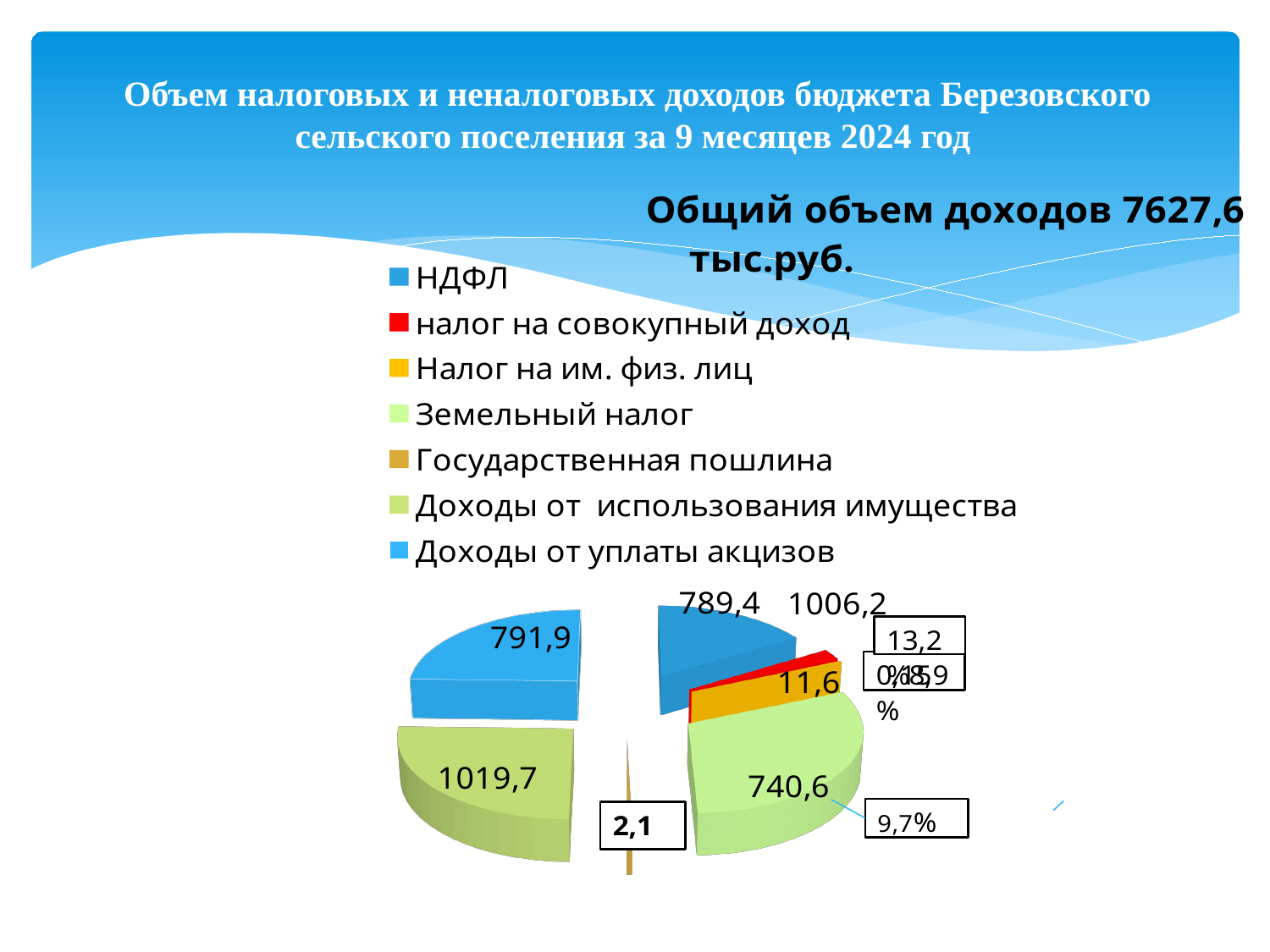
What is the value shown for Земельный налог? 740,6 What kind of chart is shown on the slide? pie chart What is the value shown for Доходы от использования имущества? 1019,7 How many categories does the legend of the pie chart list? 7 Which is larger: Доходы от использования имущества or Доходы от уплаты акцизов? Доходы от использования имущества What is the value shown for Государственная пошлина? 2,1 What total income volume (Общий объем доходов) is stated on the slide? 7627,6 тыс.руб. What is the value shown for Доходы от уплаты акцизов? 791,9 What is the value shown for НДФЛ? 789,4 What is the difference between the values for Доходы от использования имущества and Доходы от уплаты акцизов? 227,8 Which legend entry is shown in red? налог на совокупный доход